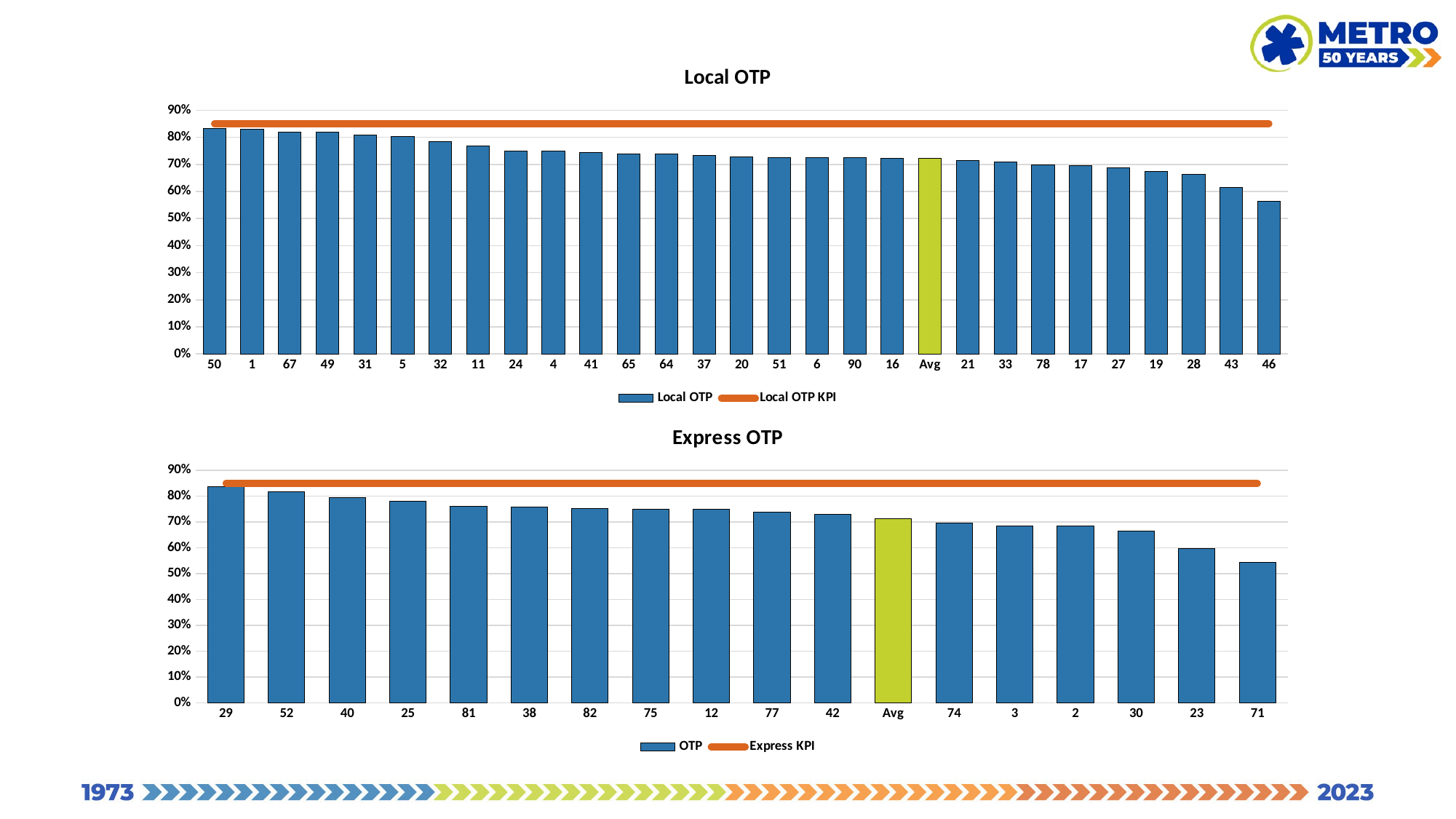
In the Express OTP chart, which route has the lowest OTP? 71 In the Local OTP chart, how many categories are shown on the x axis? 29 In the Express OTP chart, do the bar values rise or fall from left to right along the x axis? fall In the Local OTP chart, which route has the lowest OTP? 46 In the Express OTP chart, is the value for route 30 greater or less than 70%? less In the Express OTP chart, how many categories are shown on the x axis? 18 In the Local OTP chart, what is the name of the line series shown in the legend? Local OTP KPI What kind of chart is the Local OTP chart? bar chart How many series does the legend of the Express OTP chart list? 2 In the Local OTP chart, is the value for route 46 greater or less than 60%? less In the Express OTP chart, which route has the highest OTP? 29 In the Local OTP chart, is the value for route 50 greater or less than 80%? greater